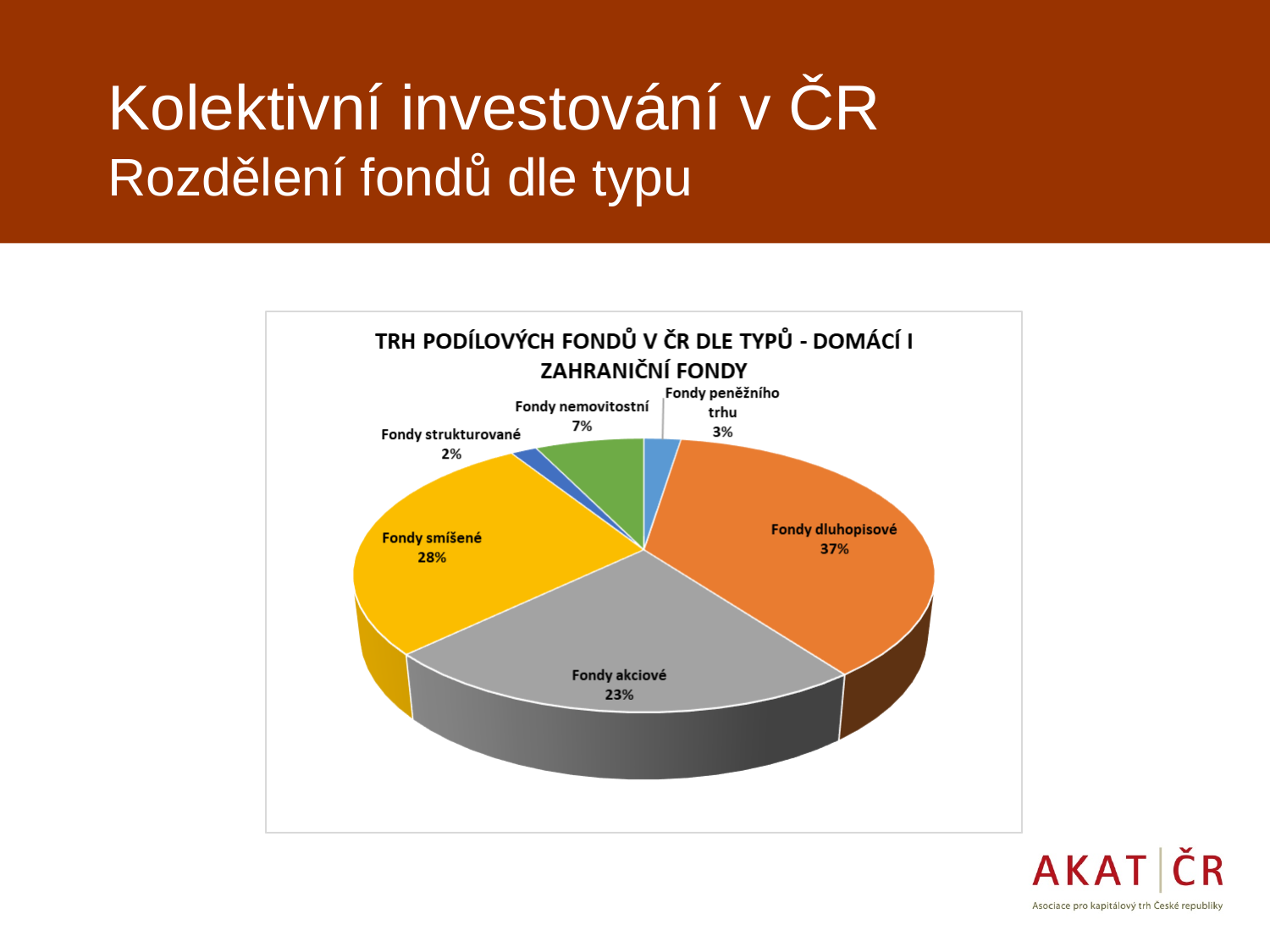
What share of the pie do Fondy nemovitostní hold? 7% How many fund types are shown in the pie chart? 6 What share of the pie do Fondy smíšené hold? 28% Which fund type has the smallest share of the pie? Fondy strukturované Which has a larger share, Fondy smíšené or Fondy akciové? Fondy smíšené Which fund type has the largest share of the pie? Fondy dluhopisové What is the difference in share between Fondy dluhopisové and Fondy akciové? 14% What colour is the slice for Fondy akciové? Grey What share of the pie do Fondy dluhopisové hold? 37% What kind of chart is shown on the slide? Pie chart